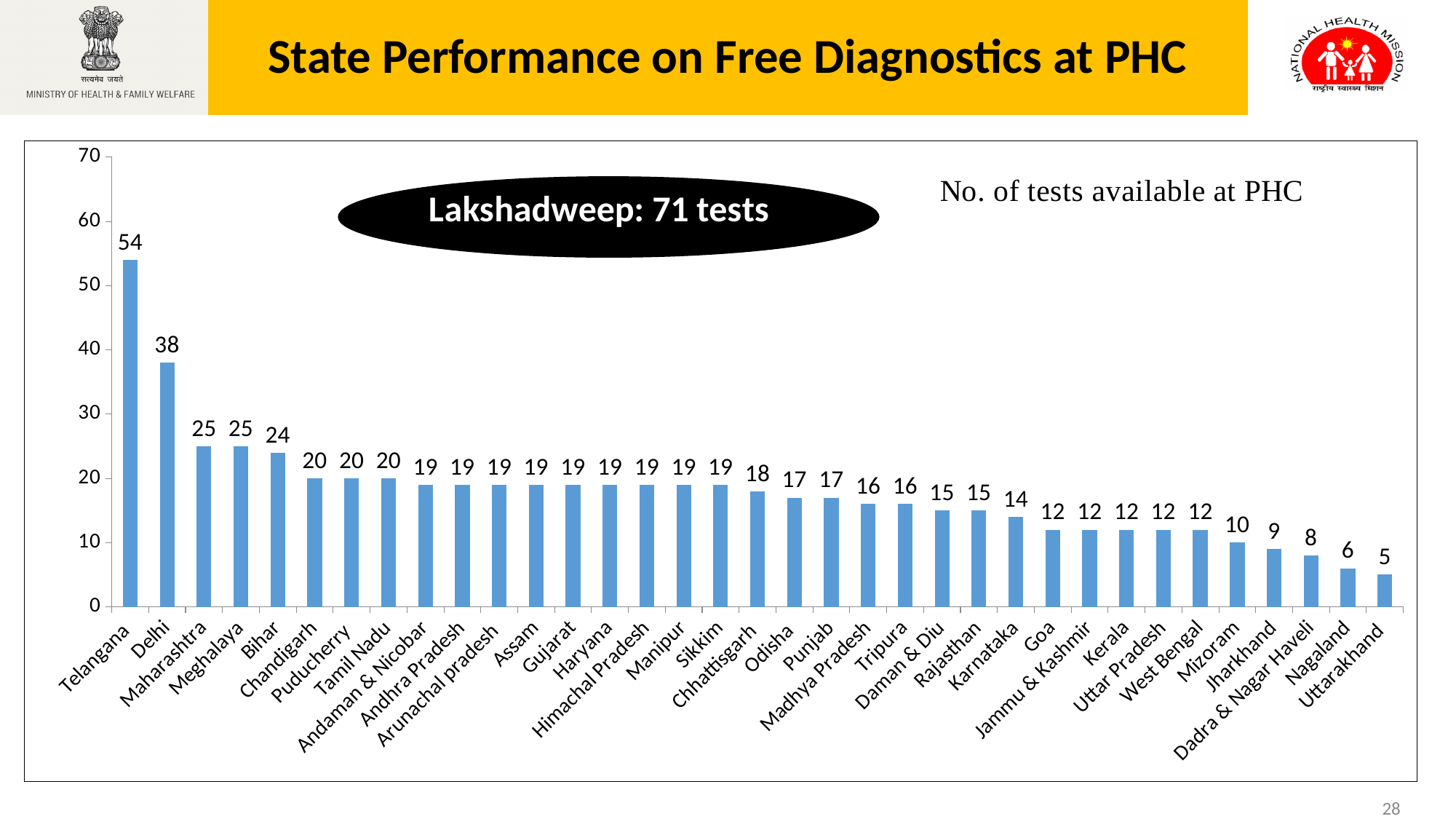
How many states/UTs are plotted as bars in the chart? 35 Which state has the lowest number of tests available at PHC? Uttarakhand Which has more tests available at PHC, Bihar or Chhattisgarh? Bihar What is the number of tests available at PHC for Karnataka? 14 What is the number of tests available at PHC for Telangana? 54 According to the callout on the chart, how many tests are available at PHC in Lakshadweep? 71 tests What is the number of tests available at PHC for Delhi? 38 What is the difference in number of tests between Telangana and Delhi? 16 Which state has the highest number of tests available at PHC among the plotted bars? Telangana Is the value for Mizoram greater or less than 20? less What type of chart is shown on the slide? bar chart Do the values rise or fall moving from left to right along the x axis? fall